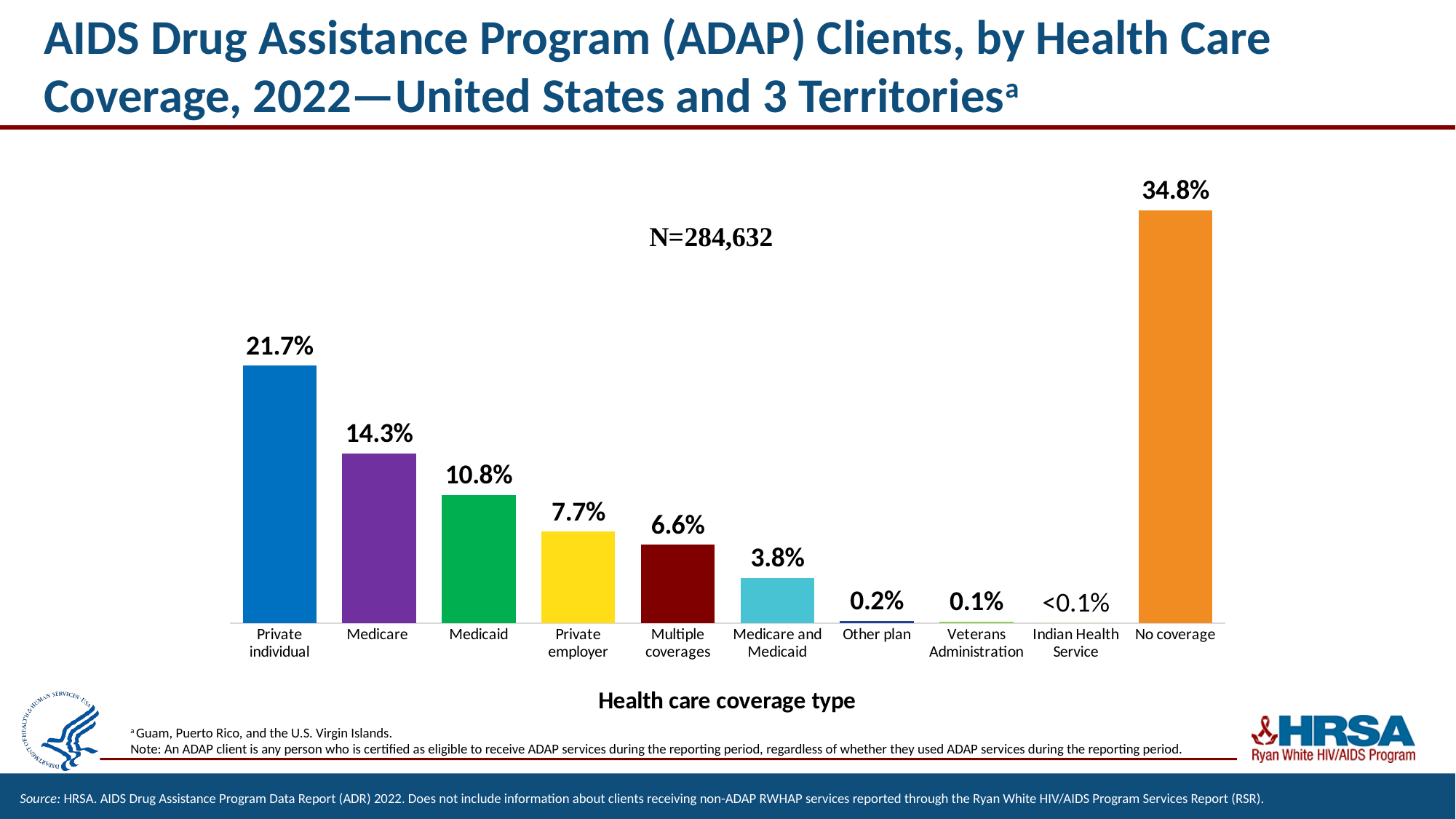
What is the difference in percentage points between Private individual and Medicaid? 10.9 What is the label of the x axis? Health care coverage type What percentage of ADAP clients had no coverage? 34.8% Which health care coverage type has the lowest percentage of ADAP clients? Indian Health Service What is the total number of ADAP clients (N) shown on the chart? 284,632 What percentage of ADAP clients had Medicare coverage? 14.3% Which health care coverage type has the highest percentage of ADAP clients? No coverage What percentage of ADAP clients had private employer coverage? 7.7% What percentage of ADAP clients had Medicare and Medicaid coverage? 3.8% Which is larger, the percentage for Multiple coverages or for Medicare and Medicaid? Multiple coverages What kind of chart is shown on the slide? Bar chart How many health care coverage types are shown on the x axis? 10